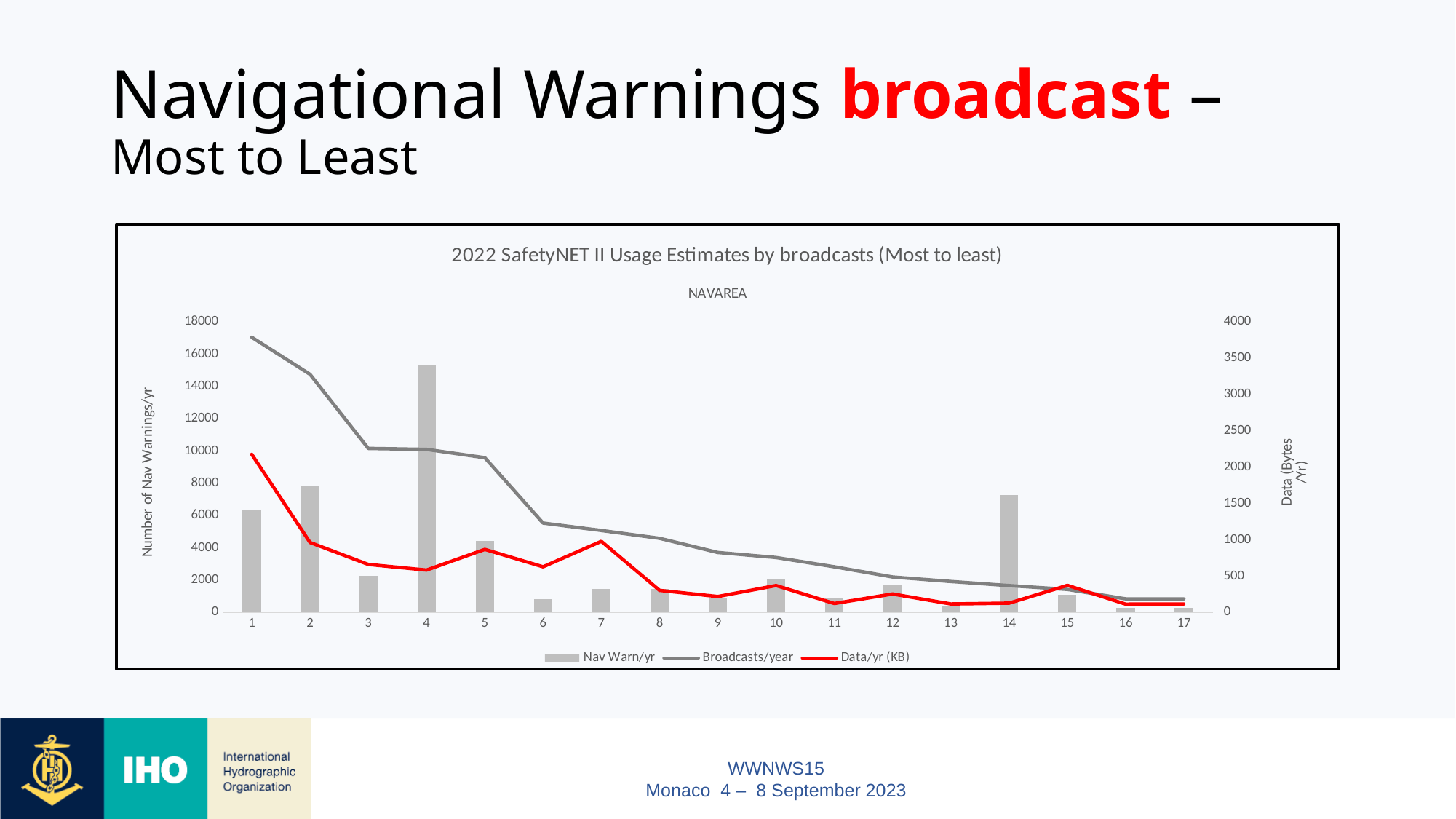
Is the Nav Warn/yr value for NAVAREA 4 greater or less than 14000? greater Is the Data/yr (KB) value for NAVAREA 1 greater or less than 1500 on the right axis? greater Does the Broadcasts/year line rise or fall from NAVAREA 1 to NAVAREA 17? Fall Which has the larger Nav Warn/yr bar, NAVAREA 5 or NAVAREA 14? NAVAREA 14 Which has the larger Nav Warn/yr bar, NAVAREA 2 or NAVAREA 4? NAVAREA 4 How many series does the legend list? 3 Is the Broadcasts/year value for NAVAREA 1 greater or less than 16000? greater What kind of chart is shown on the slide? A combined bar and line chart What is the title of the chart? 2022 SafetyNET II Usage Estimates by broadcasts (Most to least) Which NAVAREA has the highest Nav Warn/yr bar? 4 Which NAVAREA has the highest Broadcasts/year value? 1 How many NAVAREA categories are plotted along the x axis? 17